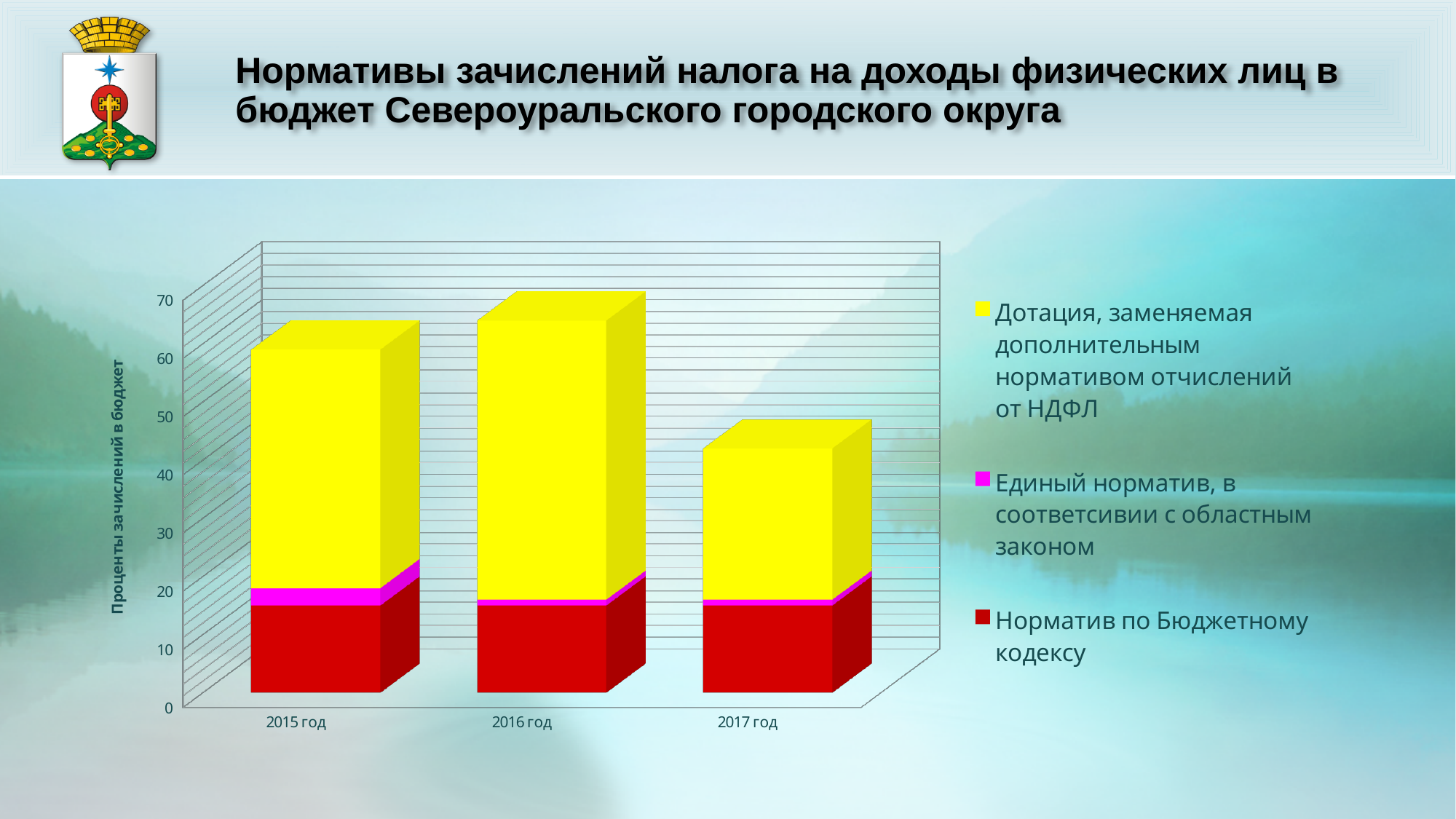
How many years (categories) are shown on the x axis of the chart? 3 Which year has the highest total stacked bar? 2016 год Which total is larger, 2015 год or 2017 год? 2015 год Is the total value for 2017 год greater or less than 60? less What colour represents the series 'Норматив по Бюджетному кодексу' in the chart? red Which total is larger, 2016 год or 2017 год? 2016 год Is the total value for 2015 год greater or less than 50? greater Which year has the lowest total stacked bar? 2017 год Does the total stacked value rise or fall from 2016 год to 2017 год? fall Is the total value for 2016 год greater or less than 60? greater How many series does the chart legend list? 3 What kind of chart is shown on the slide? stacked bar chart